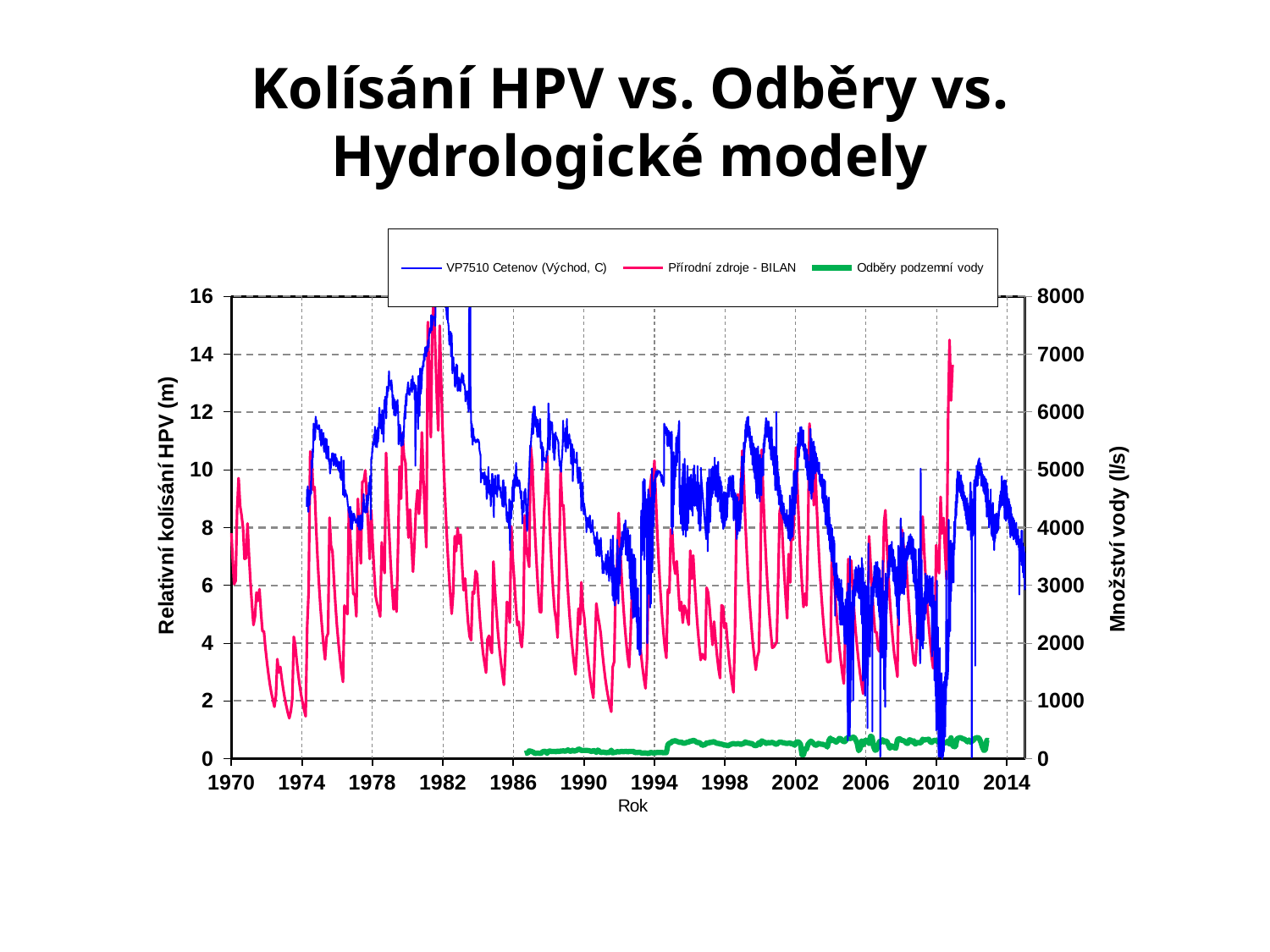
Which series stays lowest on the chart over the whole period it is plotted? Odběry podzemní vody How many series does the legend list? 3 Is the peak of the Přírodní zdroje - BILAN series around 2010 greater or less than 7000 l/s on the right axis? greater What is the label of the x axis? Rok Is the value of the Odběry podzemní vody series in 2000 greater or less than 1000 l/s on the right axis? less What is the title of the slide's chart? Kolísání HPV vs. Odběry vs. Hydrologické modely Does the Odběry podzemní vody series rise or fall overall from about 1987 to about 2012? rise Which series is drawn in green in the legend? Odběry podzemní vody Is the lowest value of the Přírodní zdroje - BILAN series around 1973 greater or less than 2000 l/s on the right axis? less Around 2000, which series is plotted higher on the chart: VP7510 Cetenov (Východ, C) or Odběry podzemní vody? VP7510 Cetenov (Východ, C) What kind of chart is shown on the slide? line chart